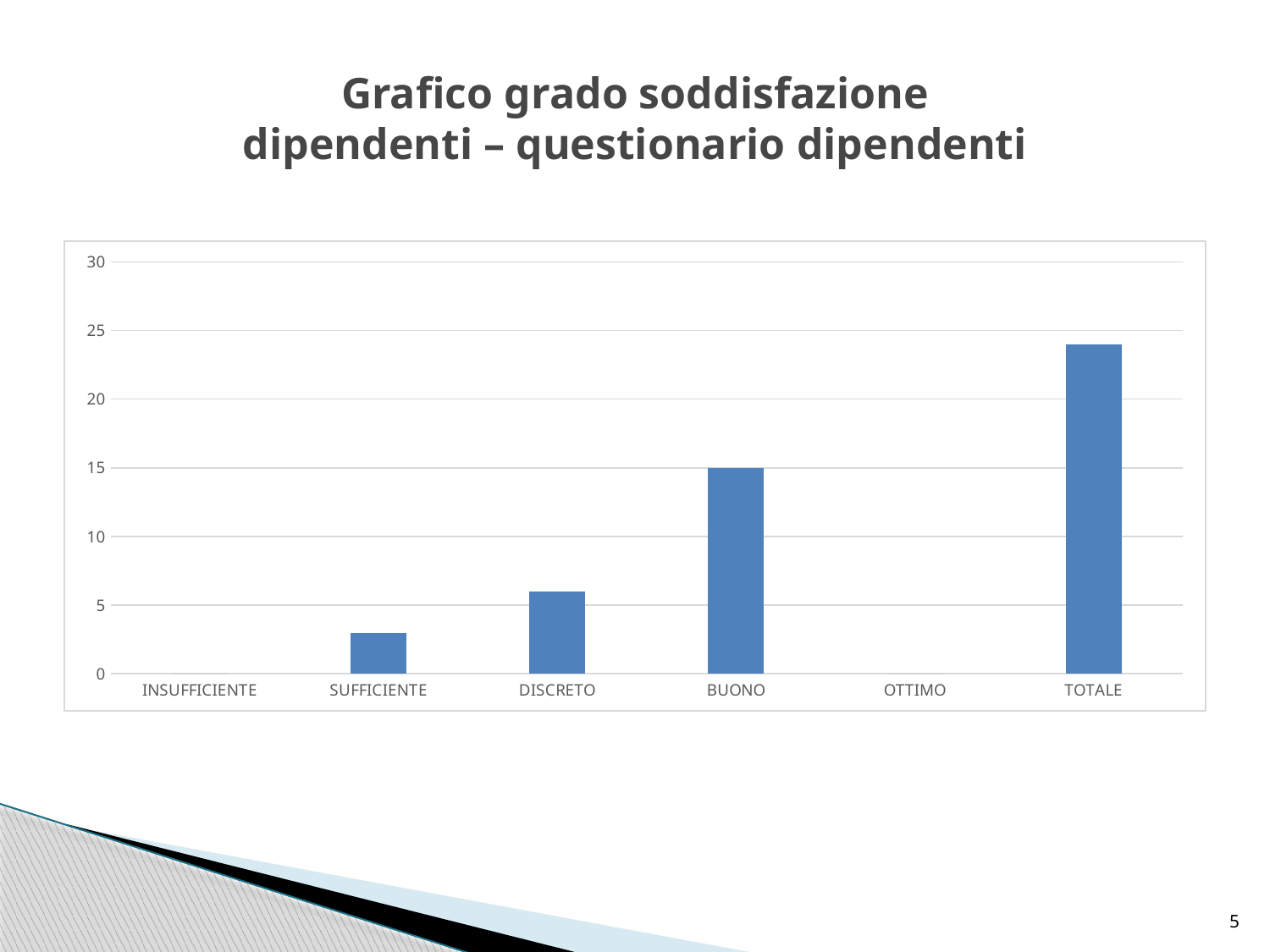
Which is larger, the value for SUFFICIENTE or the value for DISCRETO? DISCRETO Which is larger, the value for BUONO or the value for DISCRETO? BUONO What kind of chart is shown on the slide? bar chart Is the value for DISCRETO greater or less than 10? less Which category has the highest bar in the chart? TOTALE Is the value for SUFFICIENTE greater or less than 5? less What is the value for BUONO? 15 Is the value for TOTALE greater or less than 20? greater What is the title of the slide containing the chart? Grafico grado soddisfazione dipendenti – questionario dipendenti How many categories are shown on the x axis of the chart? 6